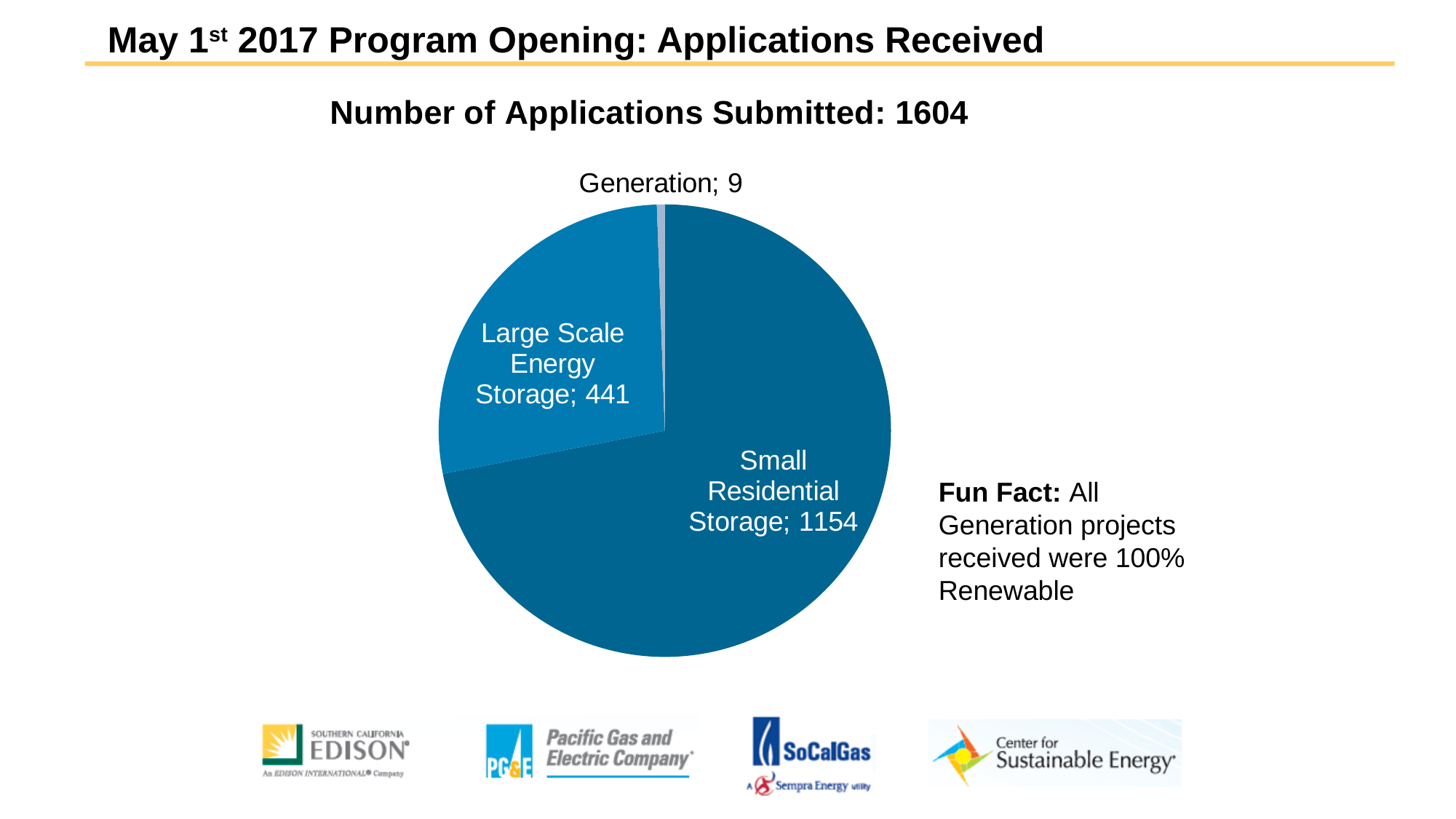
Which category received the most applications? Small Residential Storage How many applications were submitted for Generation? 9 According to the Fun Fact on the slide, what share of Generation projects received were Renewable? 100% How many categories are shown in the pie chart? 3 What is the total number of applications submitted according to the slide? 1604 Which category received the fewest applications? Generation What type of chart is shown on the slide? Pie chart Which received more applications, Large Scale Energy Storage or Generation? Large Scale Energy Storage What is the difference between the number of Large Scale Energy Storage applications and Generation applications? 432 How many applications were submitted for Large Scale Energy Storage? 441 What is the difference between the number of Small Residential Storage applications and Large Scale Energy Storage applications? 713 How many applications were submitted for Small Residential Storage? 1154